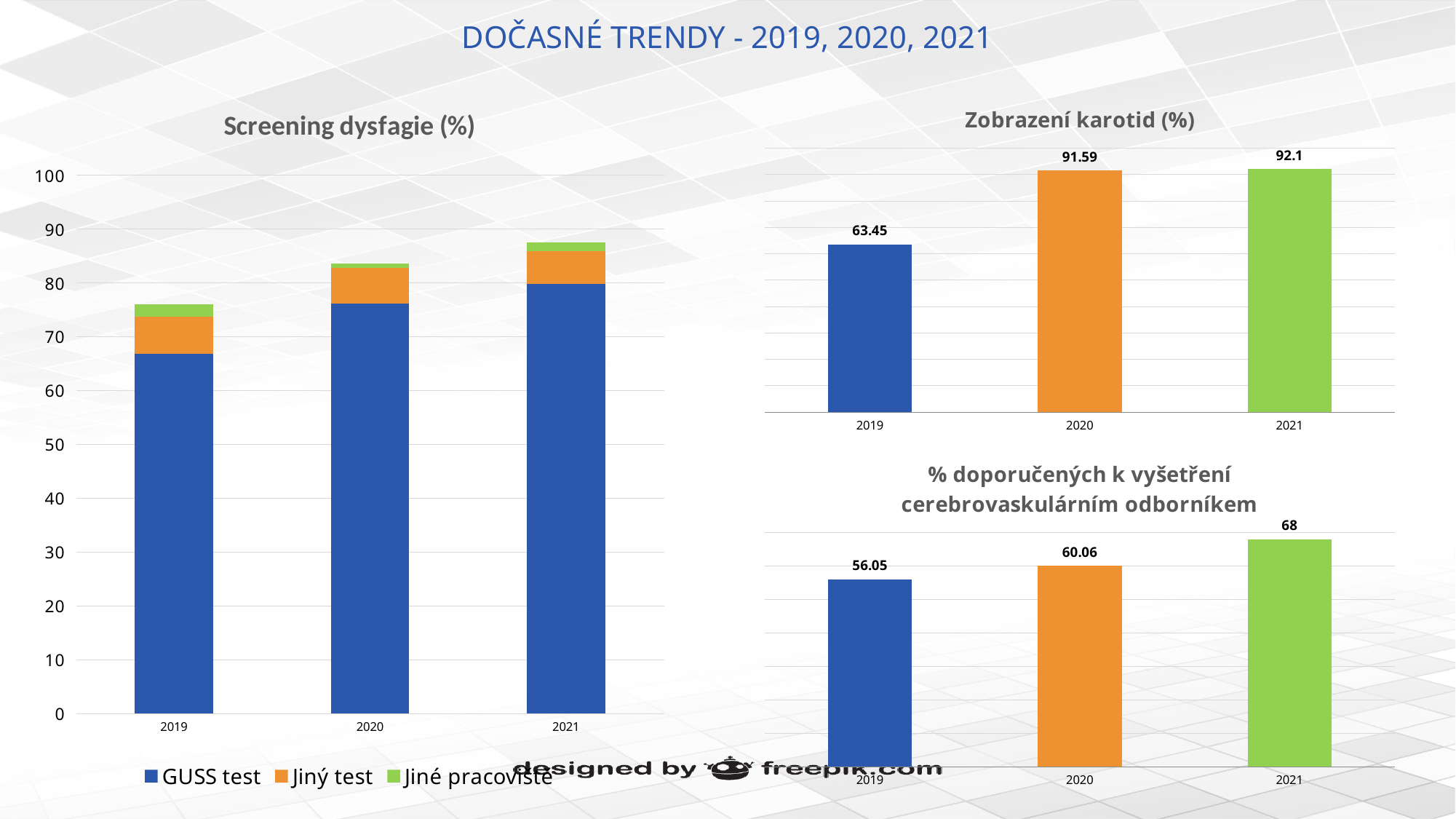
In the '% doporučených k vyšetření cerebrovaskulárním odborníkem' chart, what is the value for 2021? 68 In the '% doporučených k vyšetření cerebrovaskulárním odborníkem' chart, which year has the highest value? 2021 In the '% doporučených k vyšetření cerebrovaskulárním odborníkem' chart, what is the difference between the 2021 and 2019 values? 11.95 In the 'Screening dysfagie (%)' chart, do the total stacked bar heights rise or fall from 2019 to 2021? rise How many series does the legend of the 'Screening dysfagie (%)' chart list? 3 In the 'Zobrazení karotid (%)' chart, what is the value for 2020? 91.59 In the 'Screening dysfagie (%)' chart, is the GUSS test value for 2019 greater or less than 70? less In the 'Zobrazení karotid (%)' chart, what is the difference between the 2020 and 2019 values? 28.14 In the 'Zobrazení karotid (%)' chart, which year has the lowest value? 2019 What kind of chart is 'Screening dysfagie (%)'? Stacked bar chart In the 'Zobrazení karotid (%)' chart, what is the value for 2019? 63.45 In the '% doporučených k vyšetření cerebrovaskulárním odborníkem' chart, which is larger, the value for 2019 or 2020? 2020